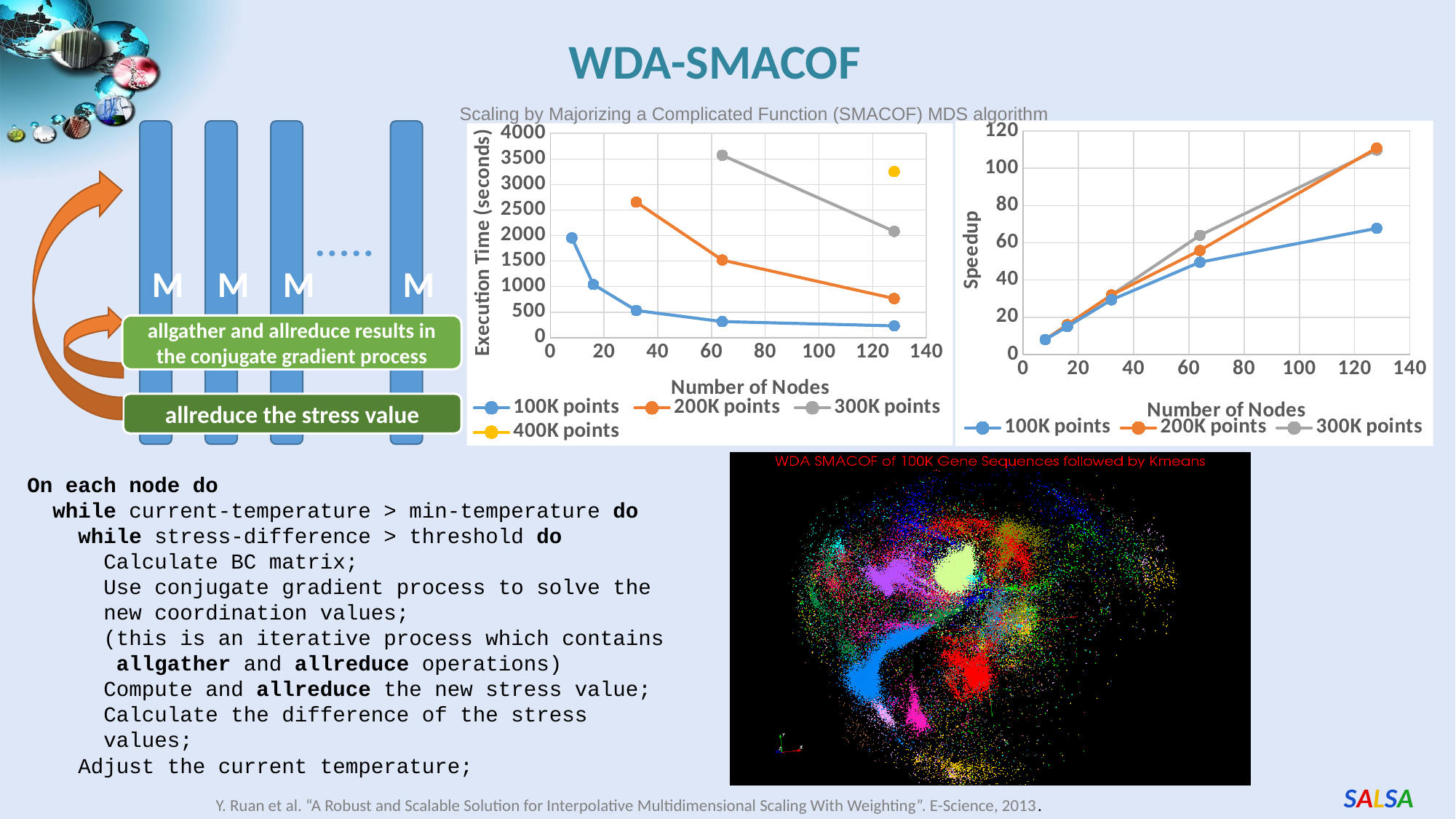
How many series does the legend of the Speedup chart list? 3 In the Execution Time chart, how many data points are plotted for the 400K points series? 1 In the Speedup chart, does the speedup for 200K points rise or fall as the number of nodes increases? rise In the Execution Time chart, does the execution time for 100K points rise or fall as the number of nodes increases? fall In the Execution Time chart, which series has the highest execution time at 128 nodes? 400K points In the Speedup chart, is the speedup for 100K points at 128 nodes greater or less than 60? greater In the Speedup chart, which series has the lowest speedup at 128 nodes? 100K points In the Execution Time chart, is the execution time for 300K points at 64 nodes greater or less than 3000? greater What is the x-axis title of the Speedup chart? Number of Nodes How many series does the legend of the Execution Time chart list? 4 What kind of chart is the Execution Time chart on the left? line chart In the Execution Time chart, is the execution time for 100K points at 128 nodes greater or less than 500? less